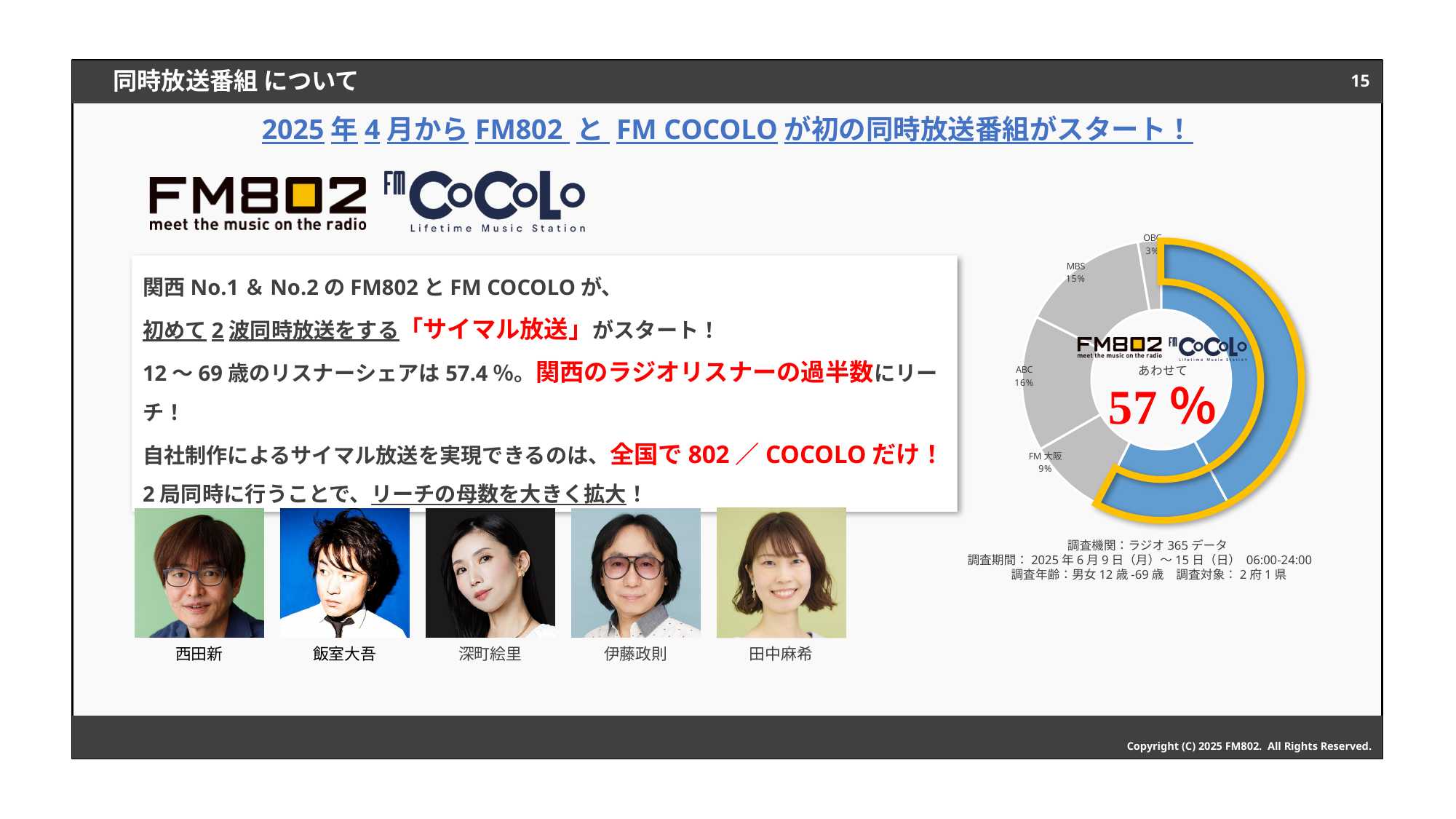
What is the share shown for FM大阪 in the donut chart? 9% What is the share shown for MBS in the donut chart? 15% How many stations other than FM802/FM COCOLO are labeled in the donut chart? 4 What colour are the FM802/FM COCOLO segments in the donut chart? blue What combined share do FM802 and FM COCOLO have in the donut chart? 57% What is the difference in share between MBS and FM大阪 in the donut chart? 6% Which of the labeled stations other than FM802/FM COCOLO has the smallest share in the donut chart? OBC What kind of chart is shown on the right side of the slide? pie chart (donut) What is the difference in share between ABC and OBC in the donut chart? 13% Which has a larger share in the donut chart, ABC or MBS? ABC What is the share shown for OBC in the donut chart? 3% What is the share shown for ABC in the donut chart? 16%